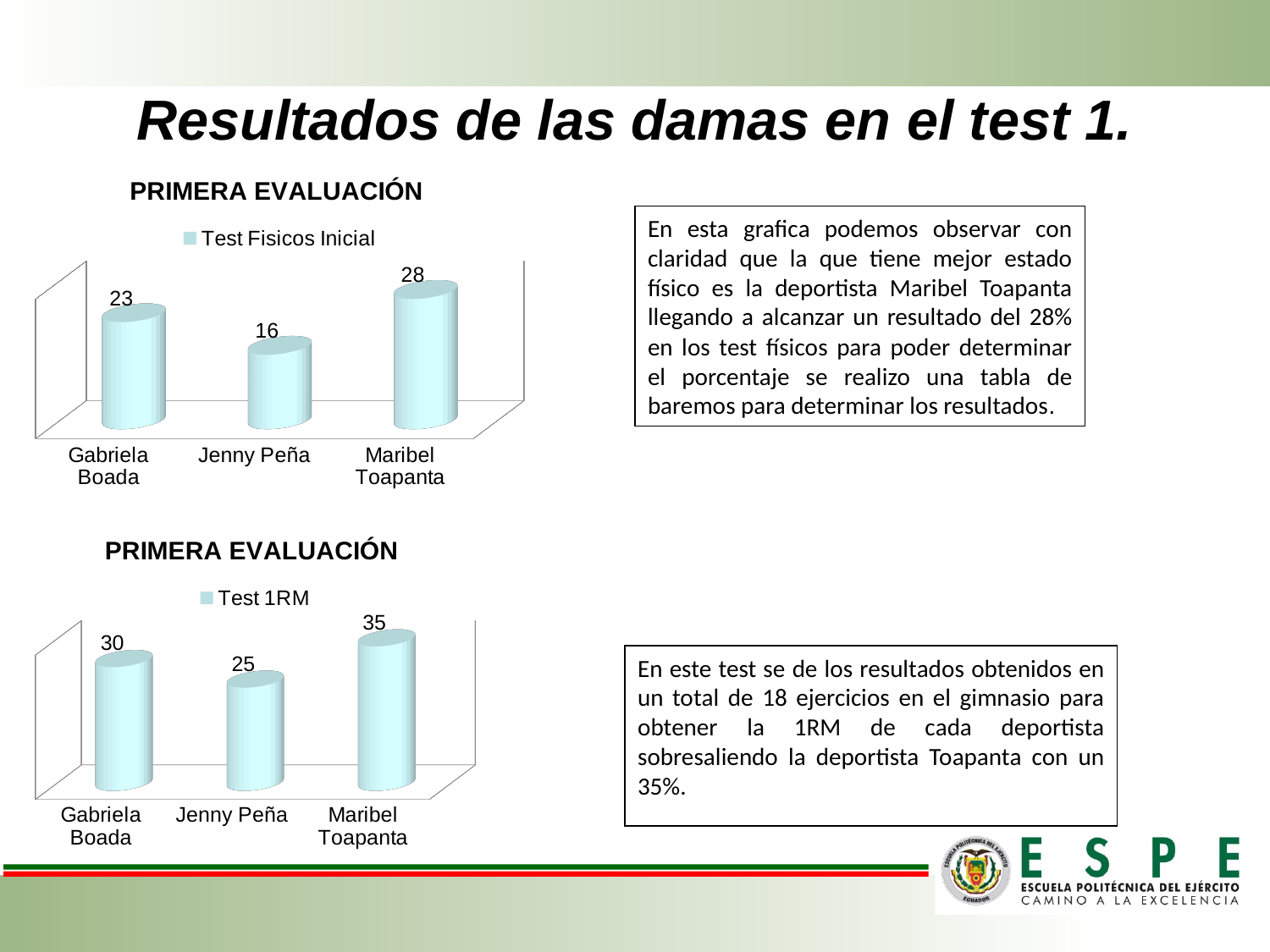
In the bottom chart (Test 1RM), which athlete has the lowest value? Jenny Peña In the bottom chart (Test 1RM), what is the value for Jenny Peña? 25 In the top chart (Test Fisicos Inicial), which athlete has the lowest value? Jenny Peña In the bottom chart (Test 1RM), what is the difference between Maribel Toapanta's and Gabriela Boada's values? 5 In the bottom chart (Test 1RM), is the value for Gabriela Boada larger or smaller than the value for Jenny Peña? larger In the top chart (Test Fisicos Inicial), what is the value for Jenny Peña? 16 In the bottom chart (Test 1RM), what is the value for Maribel Toapanta? 35 In the top chart (Test Fisicos Inicial), what is the difference between Maribel Toapanta's and Jenny Peña's values? 12 What type of chart is the bottom chart (Test 1RM)? bar chart In the top chart (Test Fisicos Inicial), what is the value for Gabriela Boada? 23 How many athletes are shown in the top chart (Test Fisicos Inicial)? 3 In the top chart (Test Fisicos Inicial), which athlete has the highest value? Maribel Toapanta